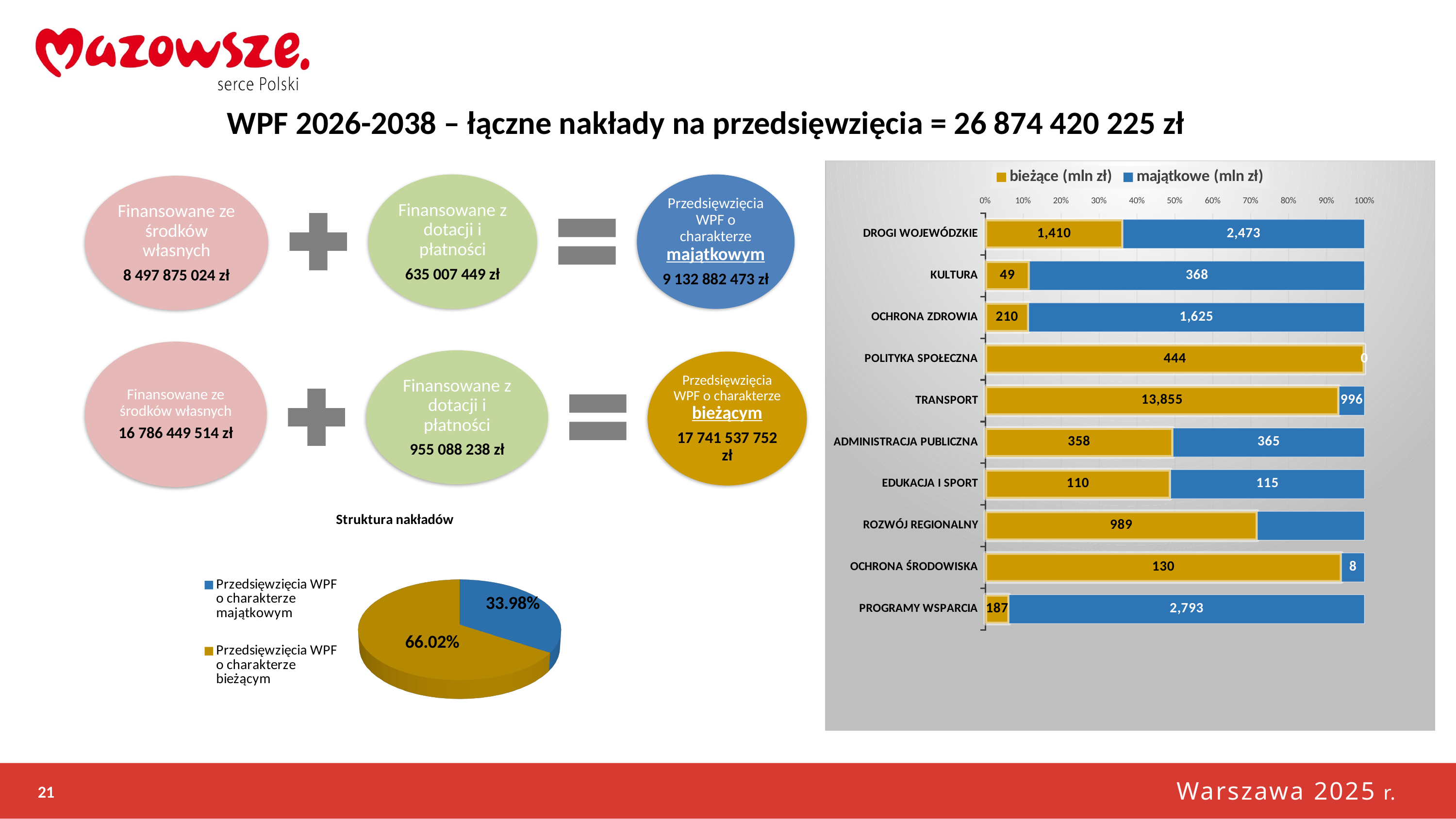
In the bar chart on the right, what is the 'bieżące (mln zł)' value for TRANSPORT? 13,855 How many categories are shown in the bar chart on the right? 10 In the pie chart 'Struktura nakładów', what share is shown for 'Przedsięwzięcia WPF o charakterze majątkowym'? 33.98% In the bar chart on the right, what is the 'majątkowe (mln zł)' value for PROGRAMY WSPARCIA? 2,793 What kind of chart is 'Struktura nakładów'? Pie chart How many series does the legend of the bar chart on the right list? 2 In the pie chart 'Struktura nakładów', which slice is larger: 'Przedsięwzięcia WPF o charakterze majątkowym' or 'Przedsięwzięcia WPF o charakterze bieżącym'? Przedsięwzięcia WPF o charakterze bieżącym In the bar chart on the right, what is the 'majątkowe (mln zł)' value for POLITYKA SPOŁECZNA? 0 In the bar chart on the right, which category has the highest 'bieżące (mln zł)' value? TRANSPORT In the bar chart on the right, which is larger for KULTURA: 'bieżące (mln zł)' or 'majątkowe (mln zł)'? majątkowe (mln zł) In the bar chart on the right, what is the difference between the 'majątkowe (mln zł)' and 'bieżące (mln zł)' values for DROGI WOJEWÓDZKIE? 1,063 In the bar chart on the right, what is the total of the 'bieżące (mln zł)' and 'majątkowe (mln zł)' values for OCHRONA ŚRODOWISKA? 138